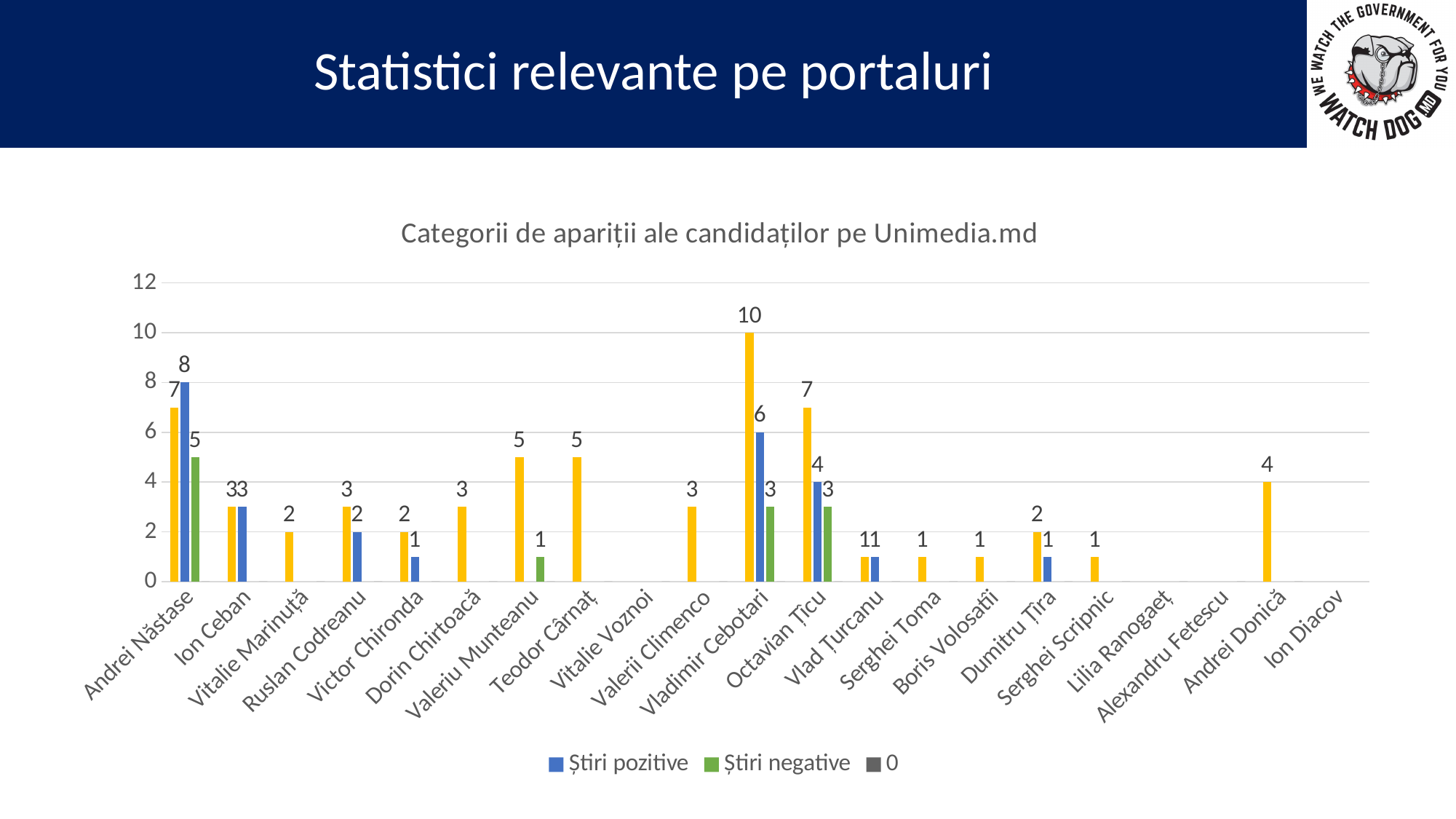
How many candidates are listed on the x axis of the chart? 21 What is the value of Știri negative for Vladimir Cebotari? 3 What is the difference between the Știri pozitive values for Andrei Năstase and Vladimir Cebotari? 2 Which candidate has the highest value for Știri pozitive? Andrei Năstase What is the value of Știri pozitive for Octavian Țîcu? 4 What is the value of Știri pozitive for Andrei Năstase? 8 Who has the larger Știri pozitive value, Octavian Țîcu or Ion Ceban? Octavian Țîcu What is the value of Știri pozitive for Vladimir Cebotari? 6 Which candidate has the highest value for Știri negative? Andrei Năstase What is the highest data label shown on the chart? 10 What type of chart is shown on the slide? Bar chart How many series does the chart legend list? 3